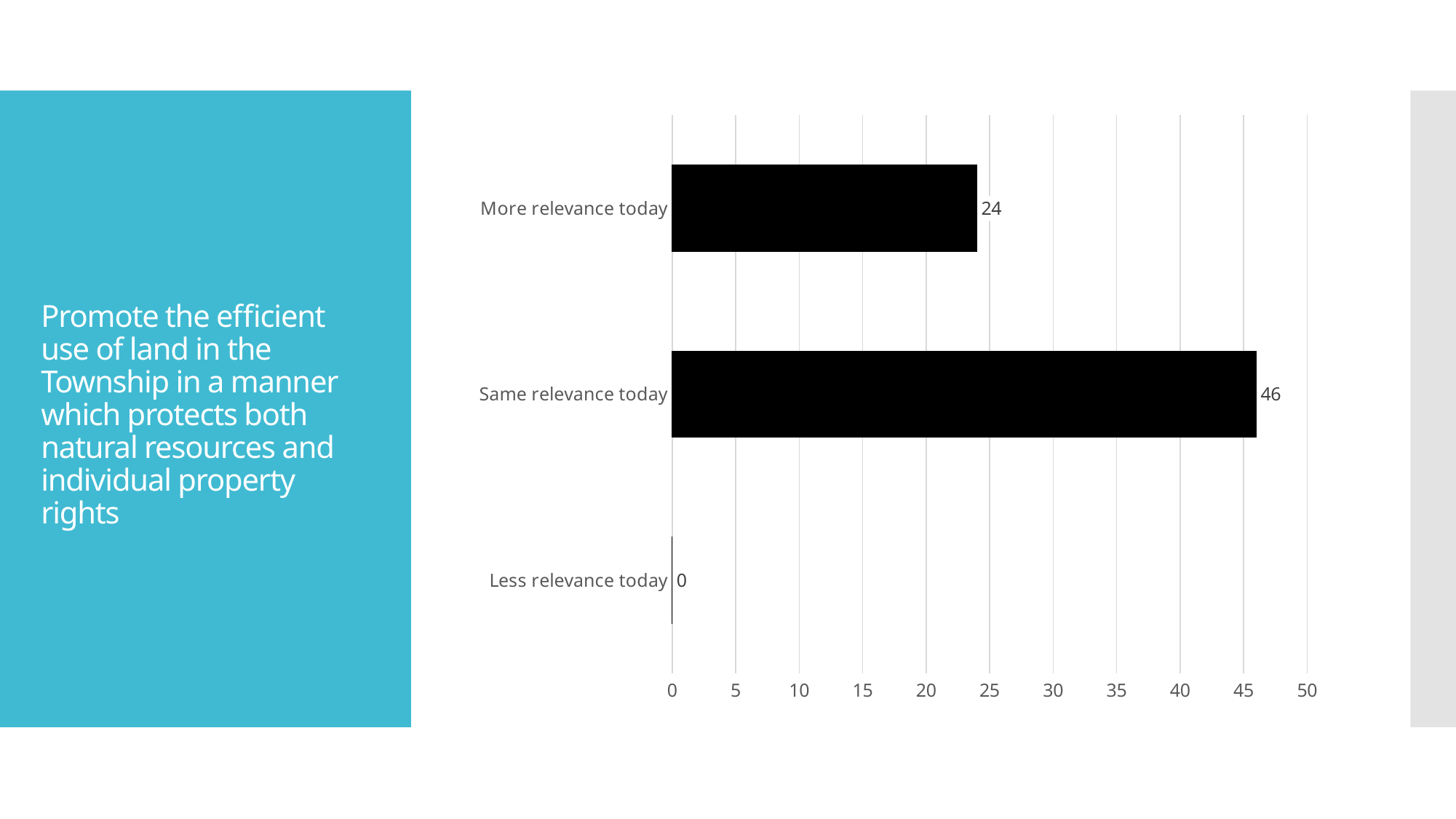
Is the value for "Same relevance today" greater or less than 40? greater Is the value for "More relevance today" greater or less than 25? less What is the value for "Less relevance today"? 0 What is the difference between the values for "Same relevance today" and "More relevance today"? 22 How many categories are shown in the chart? 3 What is the value for "More relevance today"? 24 Which is larger, the value for "More relevance today" or "Same relevance today"? Same relevance today Which category has the lowest value? Less relevance today What is the total of the three values shown in the chart? 70 Which category has the highest value? Same relevance today What kind of chart is shown on the slide? bar chart What is the value for "Same relevance today"? 46